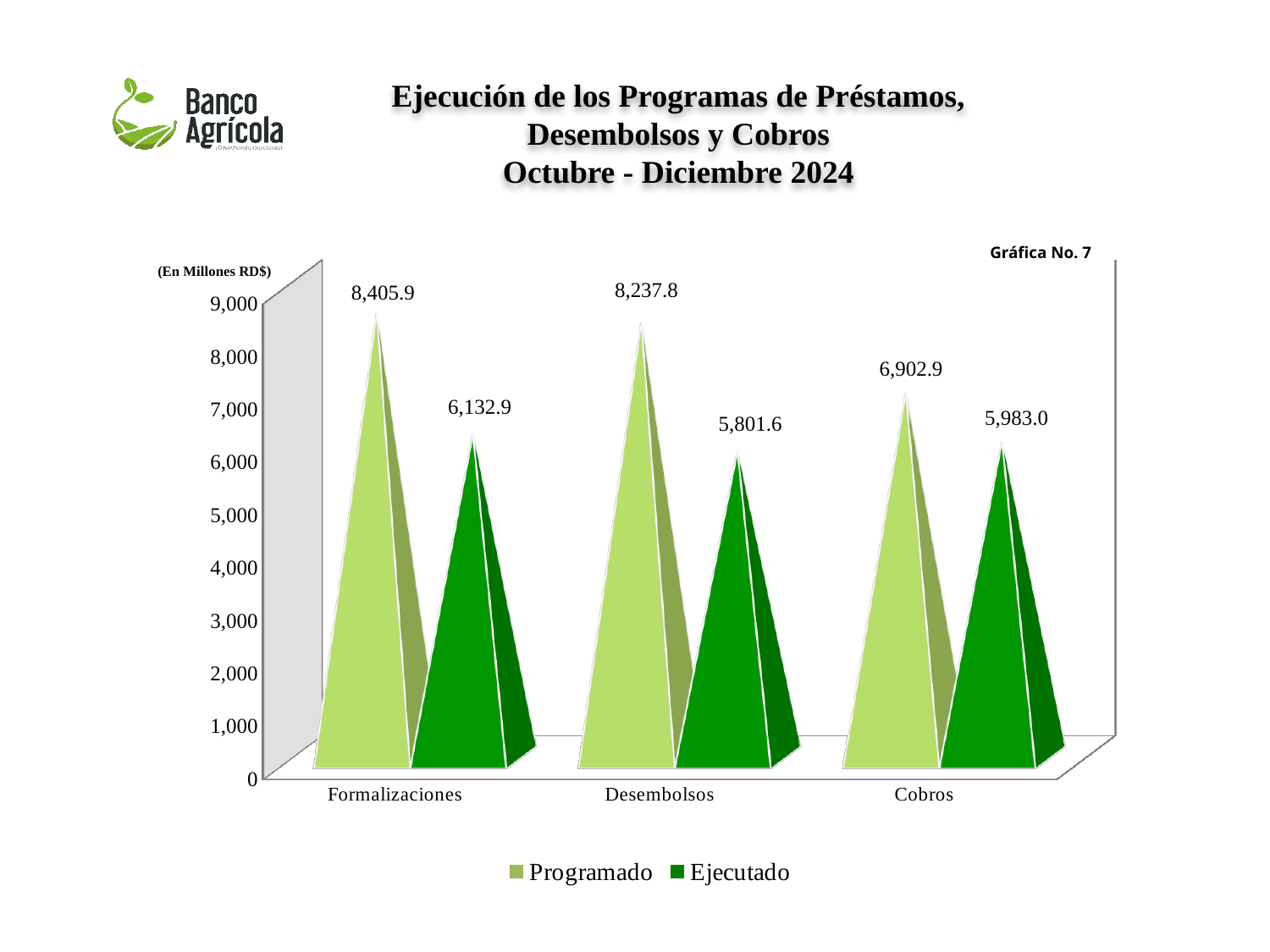
What unit is indicated for the values in the chart? En Millones RD$ How many series does the legend list? 2 What is the Programado value for Formalizaciones? 8,405.9 Which category has the lowest Ejecutado value? Desembolsos What kind of chart is shown on the slide? Bar chart Which is larger, the Ejecutado value for Formalizaciones or the Ejecutado value for Cobros? Formalizaciones What is the Ejecutado value for Cobros? 5,983.0 Which category has the highest Programado value? Formalizaciones How many categories are shown on the x axis? 3 What is the difference between the Programado and Ejecutado values for Formalizaciones? 2,273.0 What is the Ejecutado value for Desembolsos? 5,801.6 What is the difference between the Programado and Ejecutado values for Cobros? 919.9